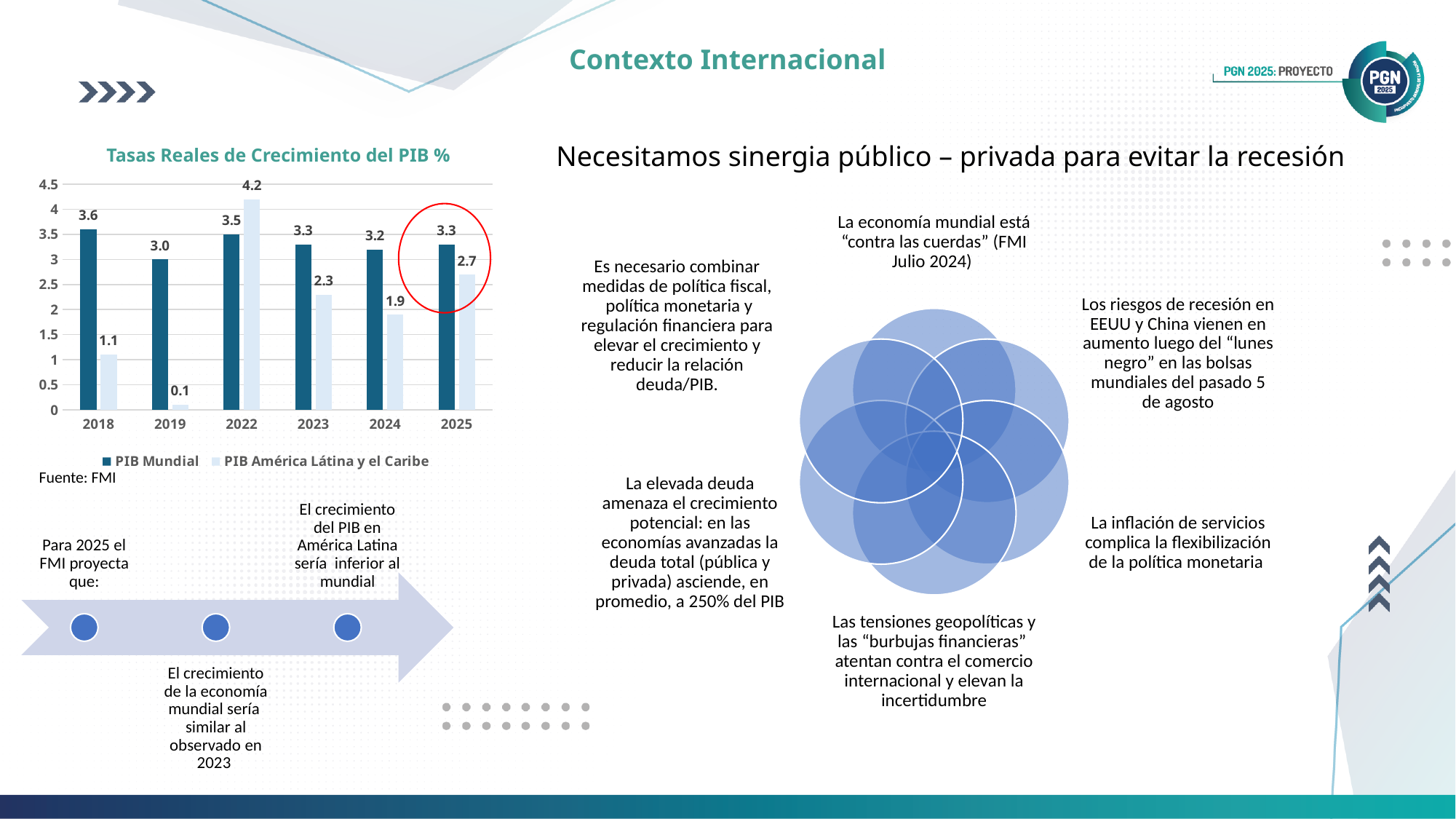
What source is cited below the chart? FMI How many years are shown on the x axis of the chart? 6 Which year has the lowest value for PIB Mundial? 2019 What is the value for PIB América Látina y el Caribe in 2025? 2.7 What kind of chart is shown on the slide? Bar chart What is the value for PIB Mundial in 2018? 3.6 In 2022, which series has the larger value: PIB Mundial or PIB América Látina y el Caribe? PIB América Látina y el Caribe What is the title of the chart? Tasas Reales de Crecimiento del PIB % Which year has the highest value for PIB América Látina y el Caribe? 2022 How many series does the chart legend list? 2 What is the value for PIB América Látina y el Caribe in 2019? 0.1 What is the difference between PIB Mundial and PIB América Látina y el Caribe in 2024? 1.3